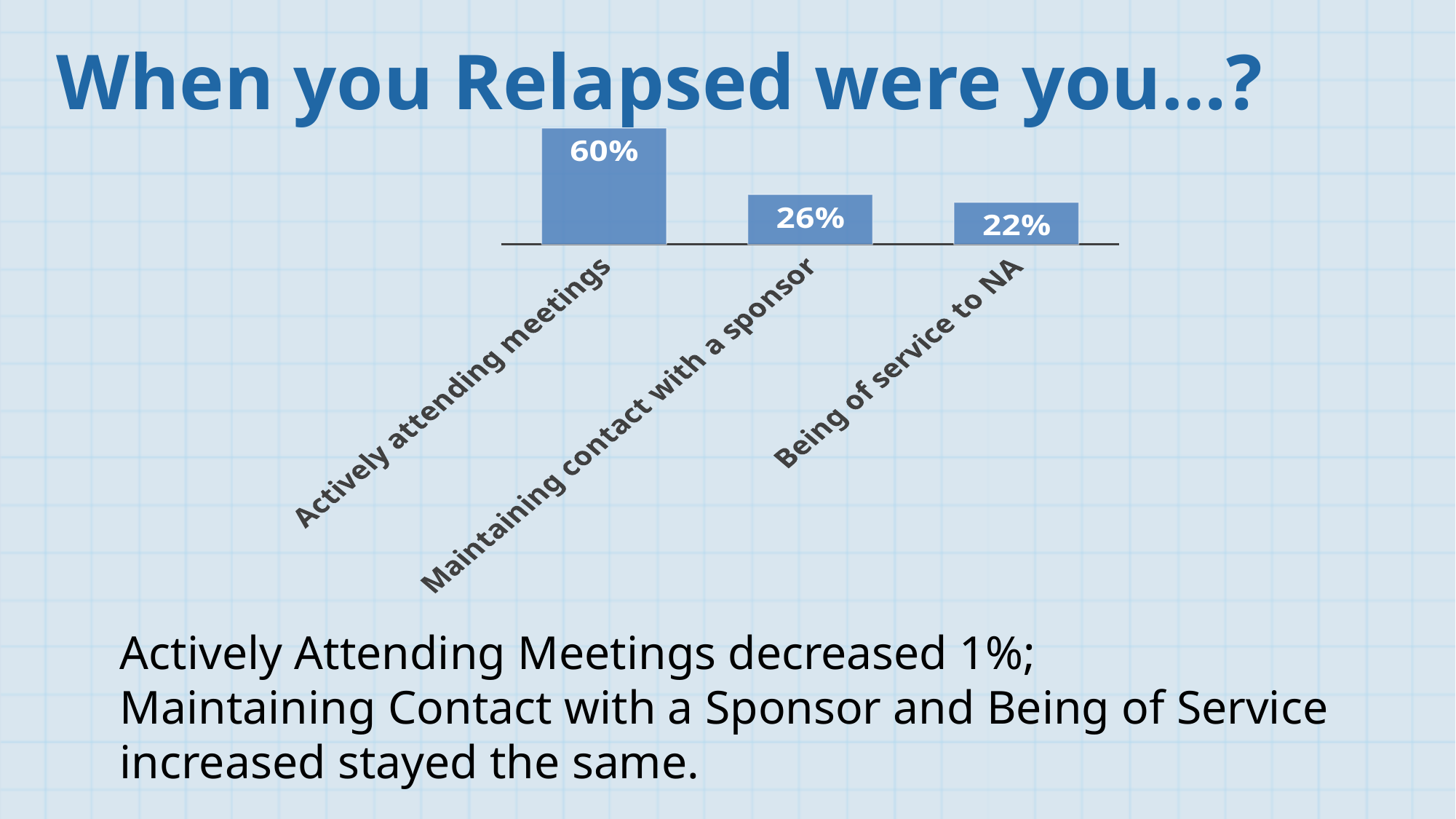
What is the difference between the values for Actively attending meetings and Maintaining contact with a sponsor? 34% How many categories are shown in the chart? 3 What is the difference between the values for Maintaining contact with a sponsor and Being of service to NA? 4% What kind of chart is shown on the slide? Bar chart Which category has the lowest value? Being of service to NA What is the value for Maintaining contact with a sponsor? 26% What is the title of the slide containing the chart? When you Relapsed were you...? Which category has the highest value? Actively attending meetings What is the value for Being of service to NA? 22% Do the values rise or fall from left to right across the categories? Fall What is the value for Actively attending meetings? 60% Which is larger, the value for Actively attending meetings or the value for Being of service to NA? Actively attending meetings